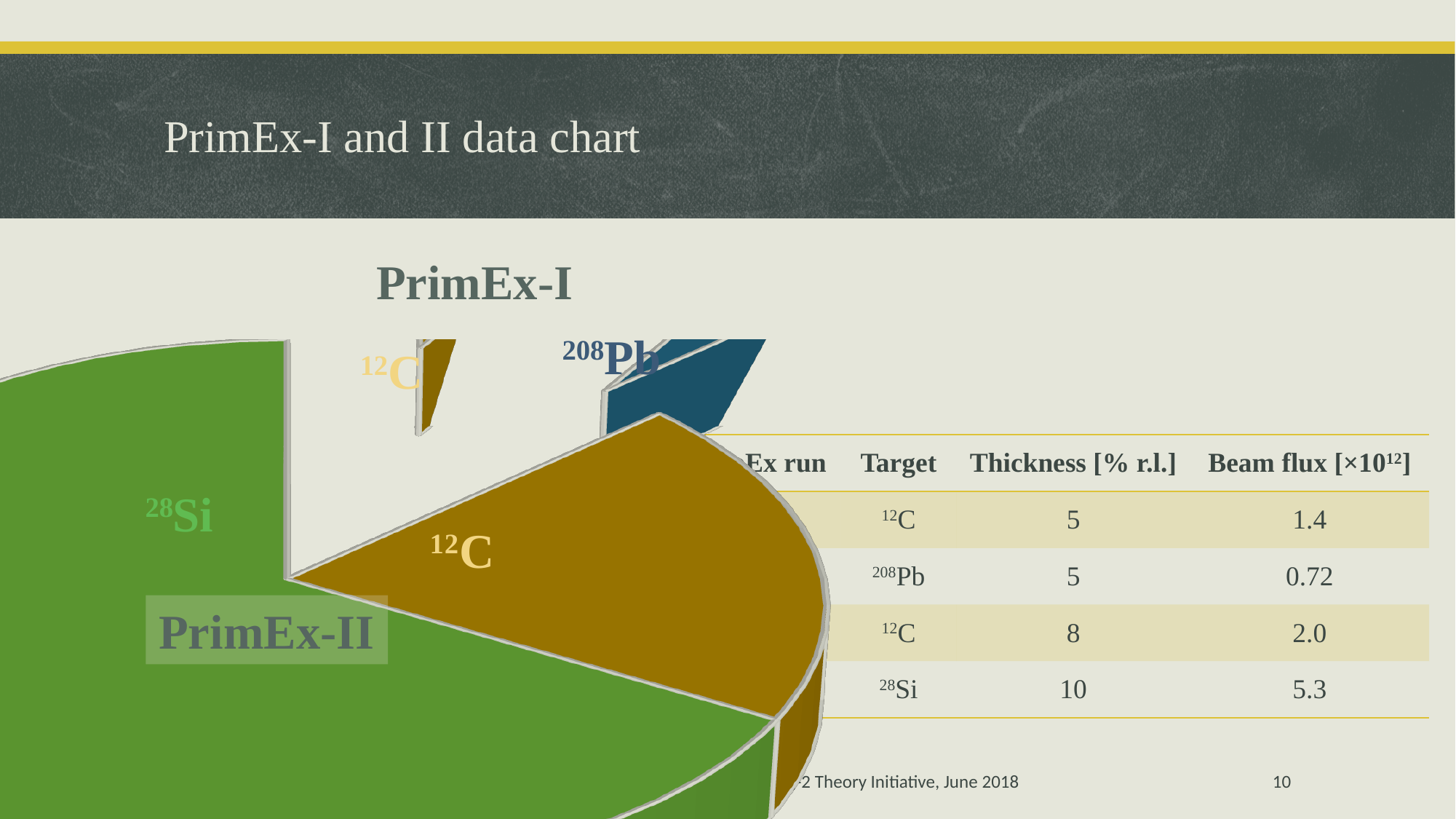
In the table next to the pie chart, what is the difference in beam flux between the 28Si target and the 208Pb target? 4.58 In the table next to the pie chart, which target has the lowest beam flux? 208Pb Which slice of the pie chart is the largest? 28Si In the pie chart, which is larger: the 208Pb slice or the small 12C slice of PrimEx-I? 208Pb Which two slices of the pie chart belong to PrimEx-I? 12C and 208Pb What is the title of the slide containing the pie chart? PrimEx-I and II data chart In the table next to the pie chart, what is the thickness of the 208Pb target? 5 What colour is the 28Si slice in the pie chart? green In the table next to the pie chart, what is the beam flux for the 28Si target? 5.3 In the pie chart, which is larger: the 28Si slice or the large 12C slice of PrimEx-II? 28Si How many slices does the pie chart have? 4 What kind of chart is shown on the slide? pie chart